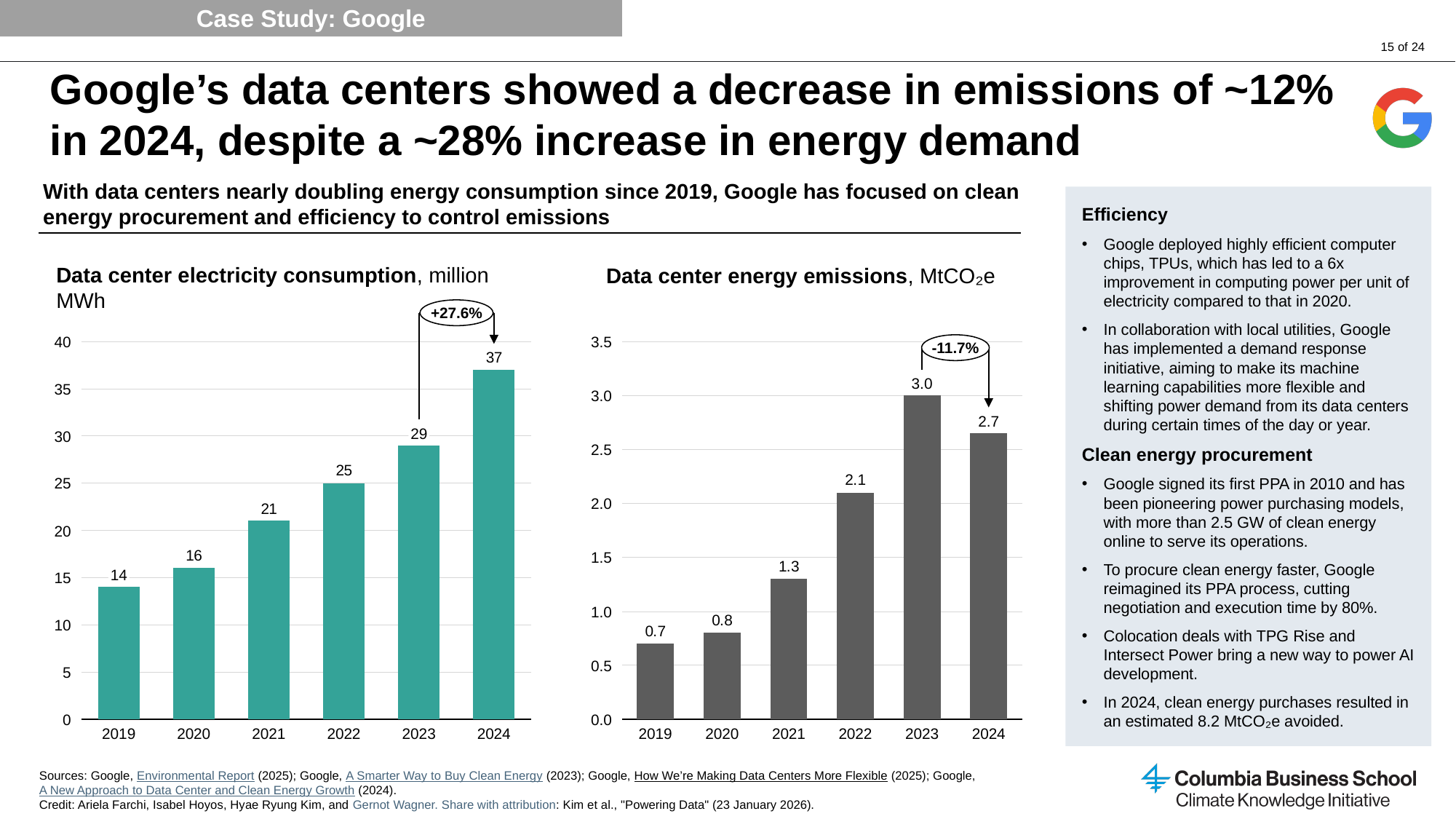
In the 'Data center electricity consumption' chart, do values rise or fall from 2019 to 2024? Rise In the 'Data center energy emissions' chart, what is the value for 2021? 1.3 In the 'Data center energy emissions' chart, which year has the lowest value? 2019 What type of chart is the 'Data center electricity consumption' chart? Bar chart In the 'Data center electricity consumption' chart, is the value for 2021 larger than the value for 2020? Yes In the 'Data center electricity consumption' chart, what is the value for 2022? 25 In the 'Data center energy emissions' chart, what is the difference between the 2023 and 2024 values? 0.3 In the 'Data center energy emissions' chart, which year has the highest value? 2023 In the 'Data center electricity consumption' chart, which year has the highest value? 2024 What percentage change is annotated between 2023 and 2024 in the 'Data center energy emissions' chart? -11.7% How many years are shown in the 'Data center energy emissions' chart? 6 In the 'Data center electricity consumption' chart, what is the difference between the 2024 and 2019 values? 23